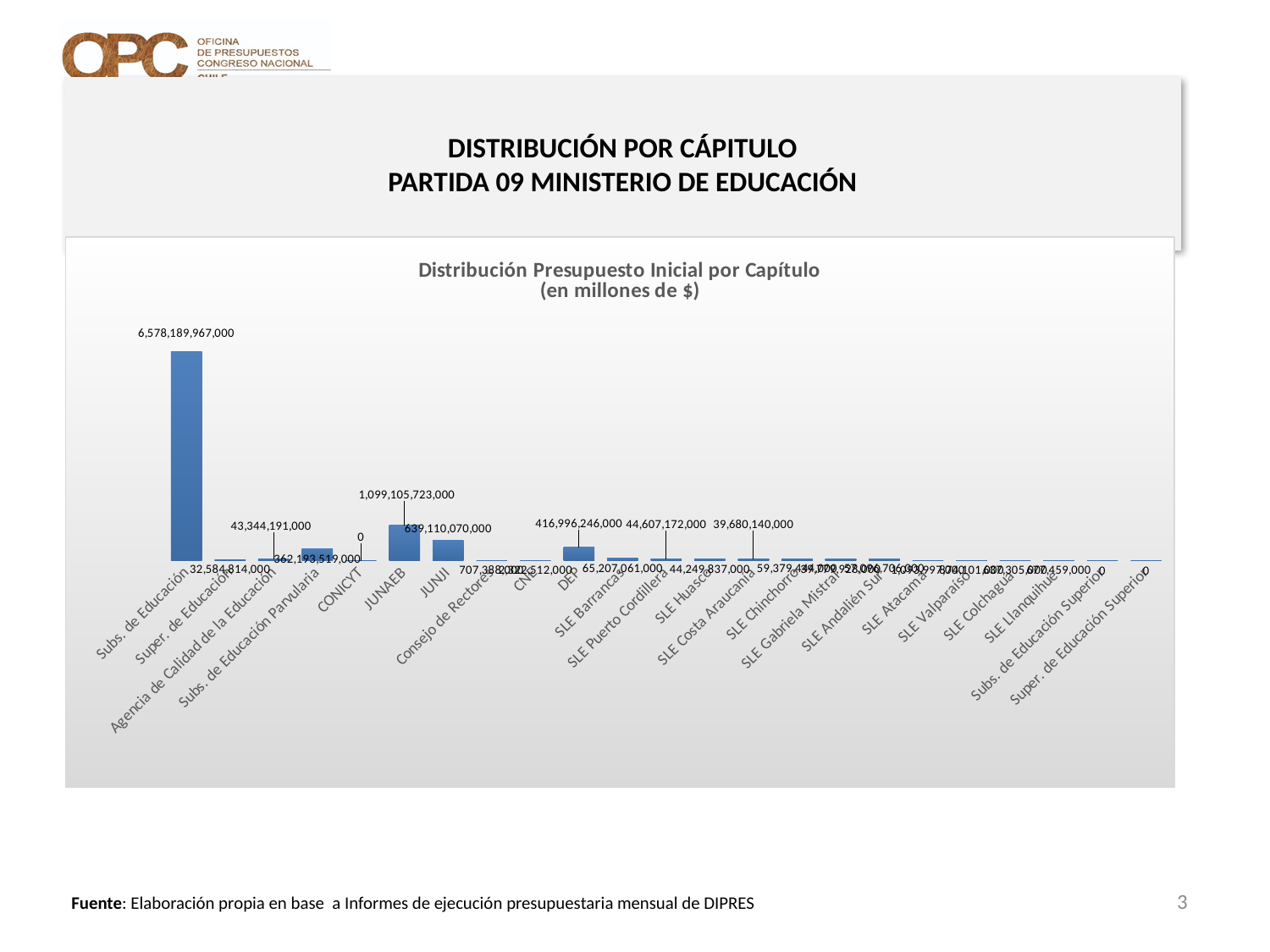
Which category has the highest value? Subs. de Educación What is the title of the chart? Distribución Presupuesto Inicial por Capítulo (en millones de $) What kind of chart is this? Bar chart What is the value for CONICYT? 0 What is the value for JUNAEB? 1,099,105,723,000 How many categories are shown on the x axis? 23 Which is larger, JUNAEB or JUNJI? JUNAEB What is the value for JUNJI? 639,110,070,000 What is the value for Subs. de Educación? 6,578,189,967,000 What is the value for Subs. de Educación Parvularia? 362,193,519,000 What is the difference between the values for JUNAEB and JUNJI? 459,995,653,000 What is the value for DEP? 416,996,246,000